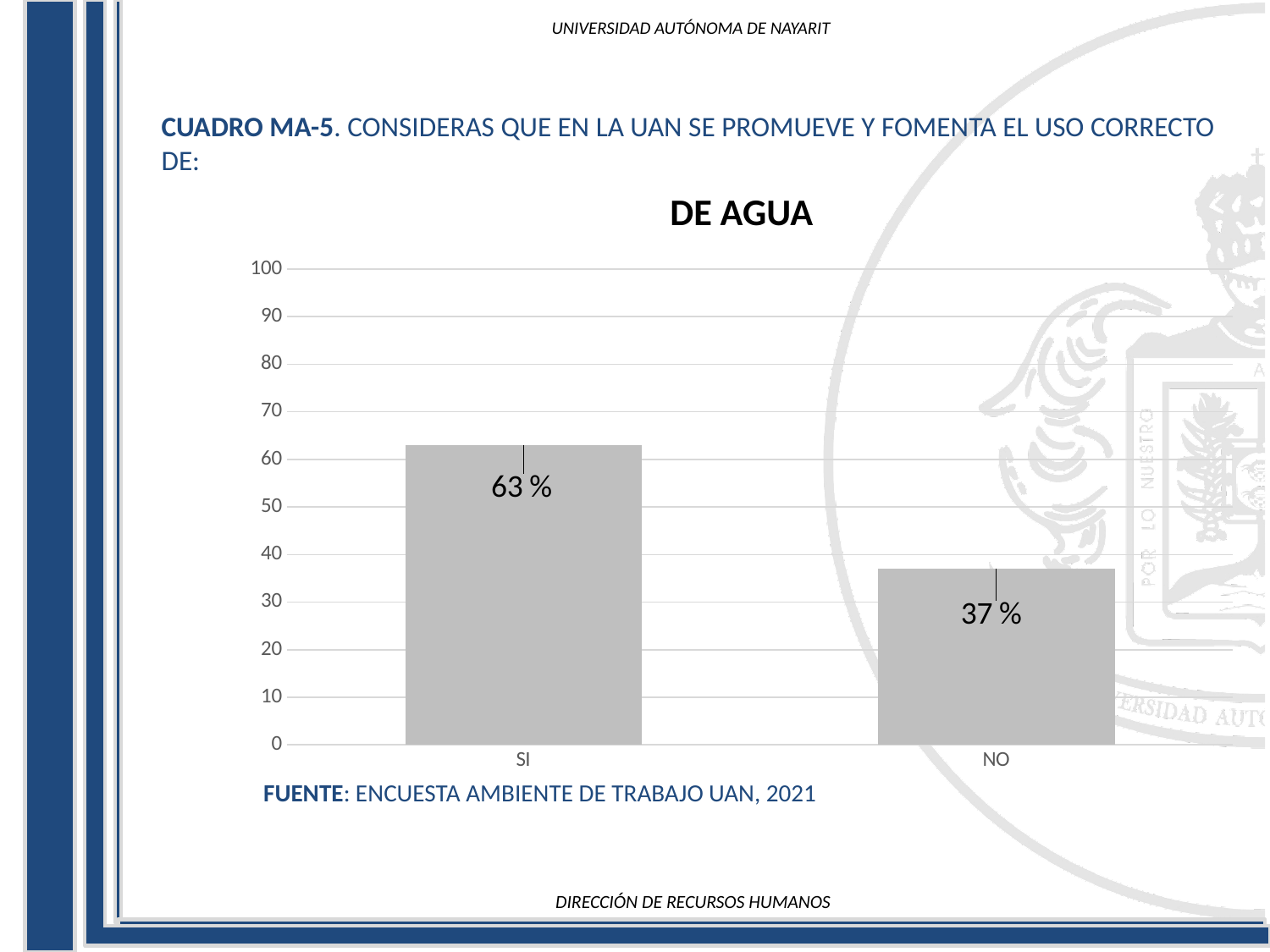
Is the value for NO greater or less than 40? less Is the value for SI greater or less than 50? greater What is the value for SI? 63 % How many categories are shown on the x axis? 2 What is the source cited below the chart? ENCUESTA AMBIENTE DE TRABAJO UAN, 2021 What is the value for NO? 37 % Which category has the highest value? SI Which category has the lowest value? NO What is the title of the chart? DE AGUA Which is larger, the value for SI or the value for NO? SI What kind of chart is shown? bar chart What is the difference between the values for SI and NO? 26 %